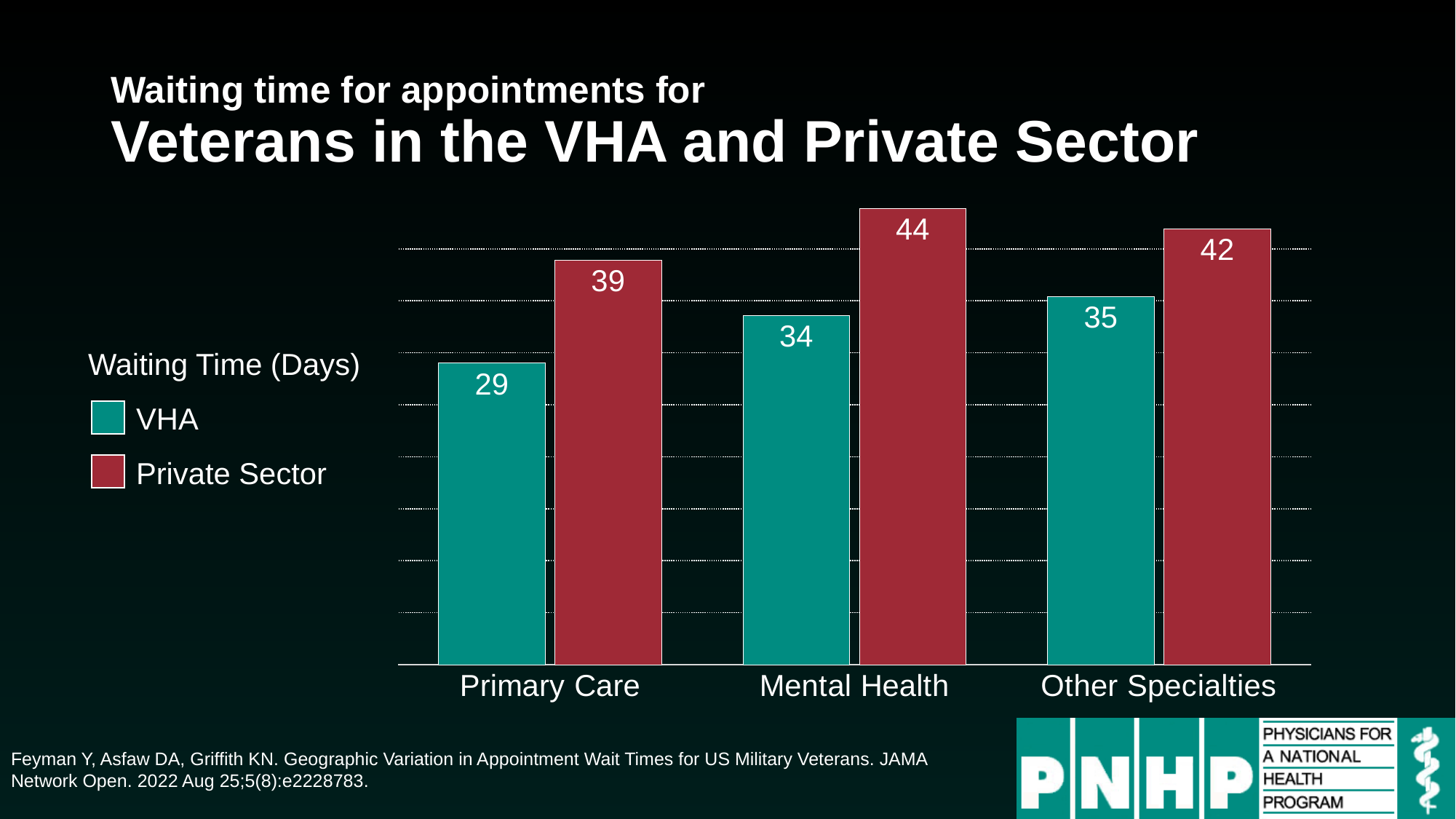
What kind of chart is shown on the slide? Bar chart What is the VHA waiting time for Primary Care? 29 Which category has the highest Private Sector waiting time? Mental Health How many categories are shown on the x axis? 3 What is the Private Sector waiting time for Mental Health? 44 How many series does the legend list? 2 What is the difference between the Private Sector and VHA waiting times for Primary Care? 10 What is the difference between the Private Sector and VHA waiting times for Other Specialties? 7 Which category has the lowest VHA waiting time? Primary Care What is the VHA waiting time for Other Specialties? 35 Which is larger for Mental Health, the VHA or the Private Sector waiting time? Private Sector What unit is the waiting time measured in, according to the legend? Days